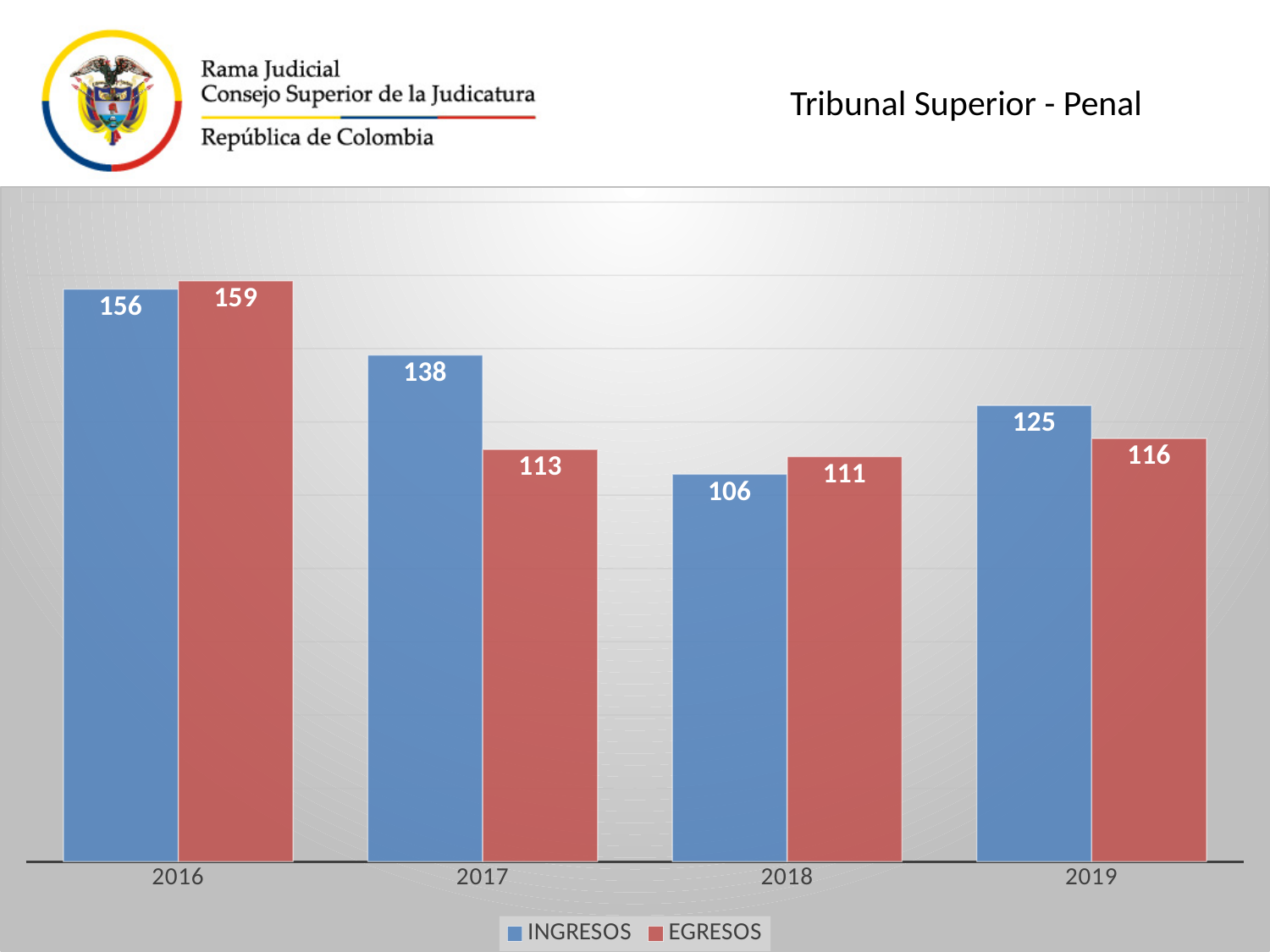
What is the difference between INGRESOS and EGRESOS in 2017? 25 What is the INGRESOS value for 2018? 106 What is the EGRESOS value for 2019? 116 What is the INGRESOS value for 2017? 138 What kind of chart is shown on the slide? Bar chart How many years are shown on the x axis? 4 Which is larger in 2018, INGRESOS or EGRESOS? EGRESOS How many series does the legend list? 2 Which year has the highest EGRESOS value? 2016 What is the difference between the INGRESOS values for 2016 and 2019? 31 Which year has the lowest INGRESOS value? 2018 Does the INGRESOS series rise or fall from 2016 to 2018? Fall